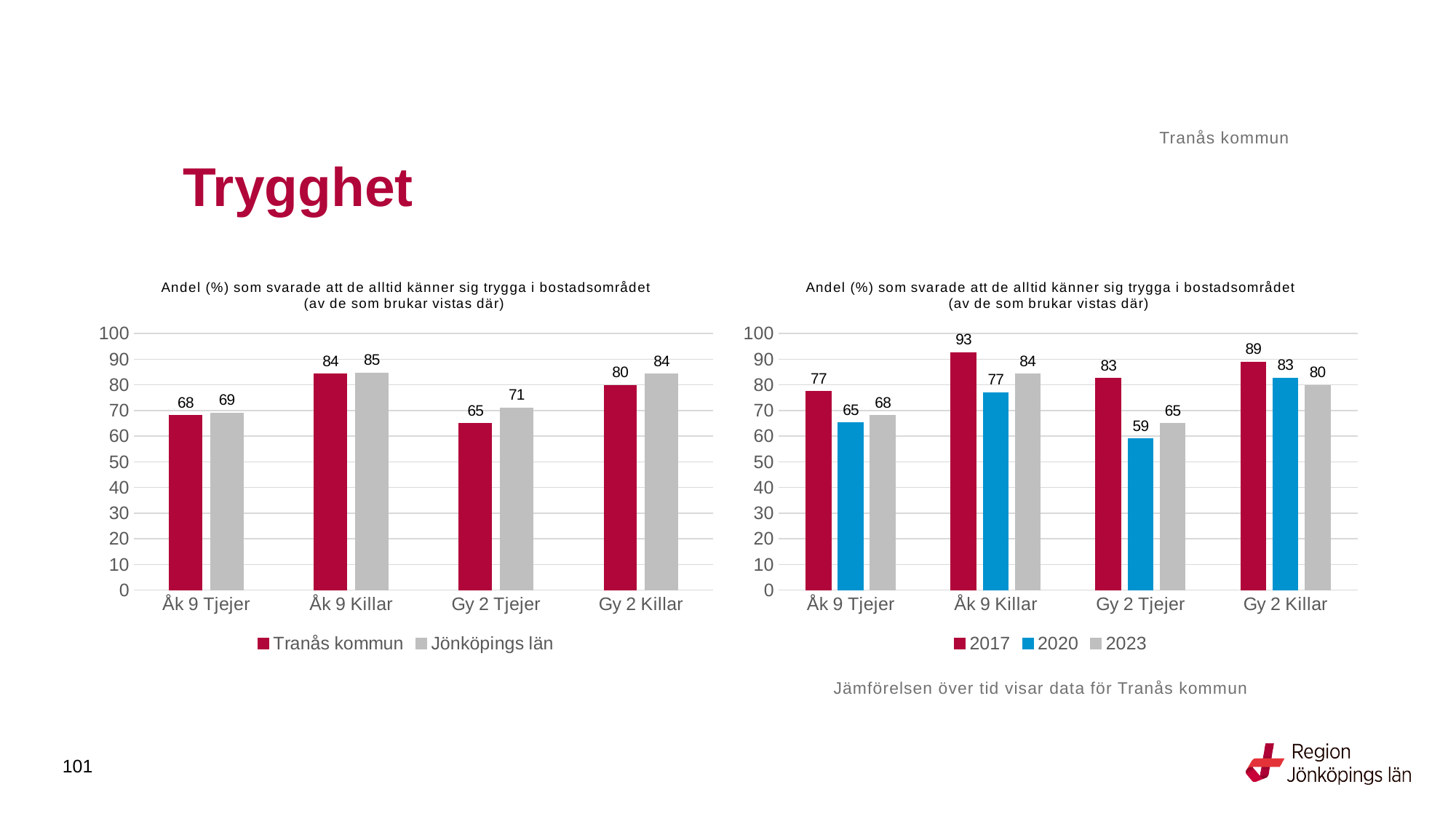
In the right chart, which category has the lowest 2020 value? Gy 2 Tjejer In the right chart, which is larger for Gy 2 Killar: the 2020 value or the 2023 value? 2020 In the right chart, which category has the highest 2017 value? Åk 9 Killar In the right chart, what is the 2020 value for Gy 2 Tjejer? 59 In the left chart, what is the value for Tranås kommun for Gy 2 Tjejer? 65 In the right chart, do the values for Gy 2 Killar rise or fall from 2017 to 2023? fall In the right chart, what is the difference between the 2017 and 2023 values for Åk 9 Killar? 9 How many series does the legend of the right chart list? 3 In the left chart, what is the difference between Jönköpings län and Tranås kommun for Gy 2 Tjejer? 6 How many categories are shown on the x axis of the left chart? 4 What kind of chart is the left chart? bar chart In the left chart, what is the value for Jönköpings län for Gy 2 Killar? 84